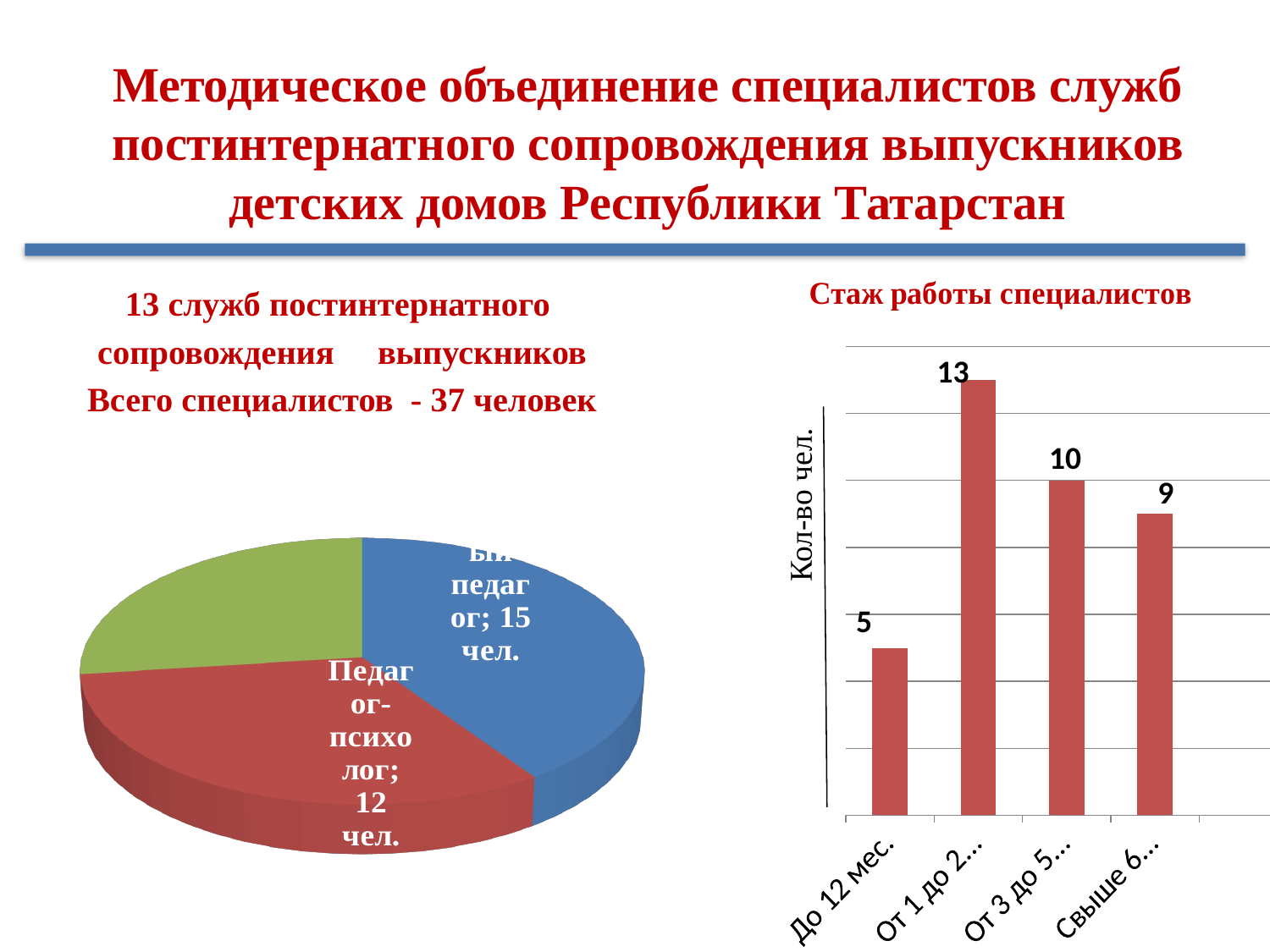
How many bars are there in the chart "Стаж работы специалистов"? 4 What kind of chart is the chart titled "Стаж работы специалистов" on the right of the slide? bar chart In the chart "Стаж работы специалистов", what is the value of the second bar ("От 1 до 2…")? 13 In the pie chart on the left of the slide, how many people are shown for "Педагог-психолог"? 12 чел. In the chart "Стаж работы специалистов", what is the value for "До 12 мес."? 5 How many slices does the pie chart on the left of the slide have? 3 In the chart "Стаж работы специалистов", what is the difference between the value for "От 1 до 2…" and the value for "До 12 мес."? 8 What is the label of the vertical axis in the chart "Стаж работы специалистов"? Кол-во чел. In the chart "Стаж работы специалистов", which is larger: the value for "От 3 до 5…" or the value for "Свыше 6…"? От 3 до 5… In the chart "Стаж работы специалистов", what is the highest value shown on any bar? 13 In the chart "Стаж работы специалистов", which category has the lowest value? До 12 мес. What kind of chart is the chart on the left of the slide, below the text "Всего специалистов - 37 человек"? pie chart